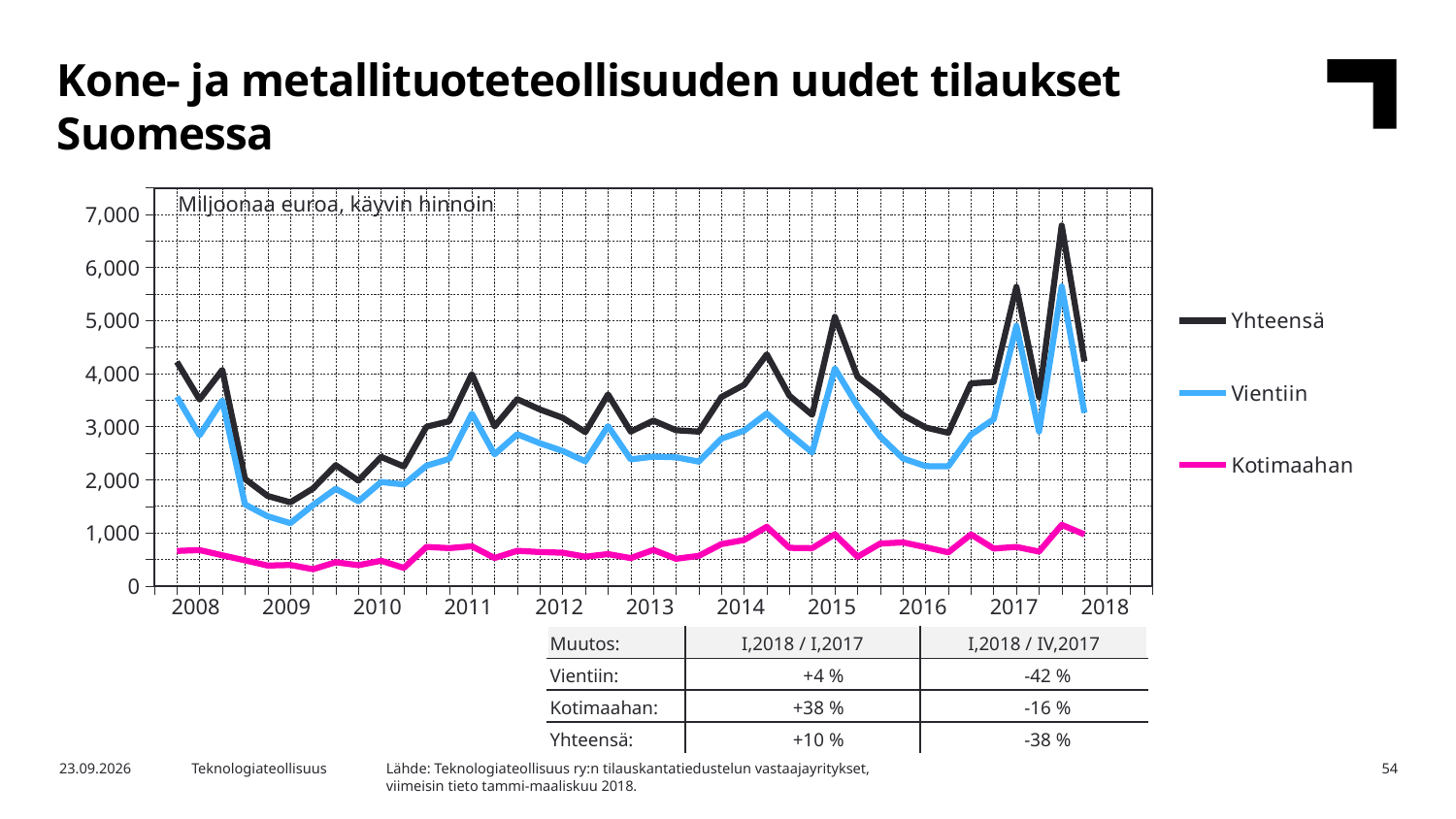
Is the peak value of the Vientiin line in 2017 greater or less than 5,000? greater Which series reaches the highest value on the chart? Yhteensä Does the Yhteensä line rise or fall from the start of 2008 to 2009? fall Which is larger at every point on the chart, Vientiin or Kotimaahan? Vientiin Which series are listed in the chart legend? Yhteensä, Vientiin, Kotimaahan Which series has the lowest values throughout the whole period? Kotimaahan Is the peak value of the Yhteensä line in 2017 greater or less than 6,000? greater How many year labels are shown on the x axis? 11 What kind of chart is shown on the slide? line chart How many series does the legend list? 3 What unit is stated at the top of the chart area? Miljoonaa euroa, käyvin hinnoin Is the highest value of the Kotimaahan line greater or less than 2,000? less